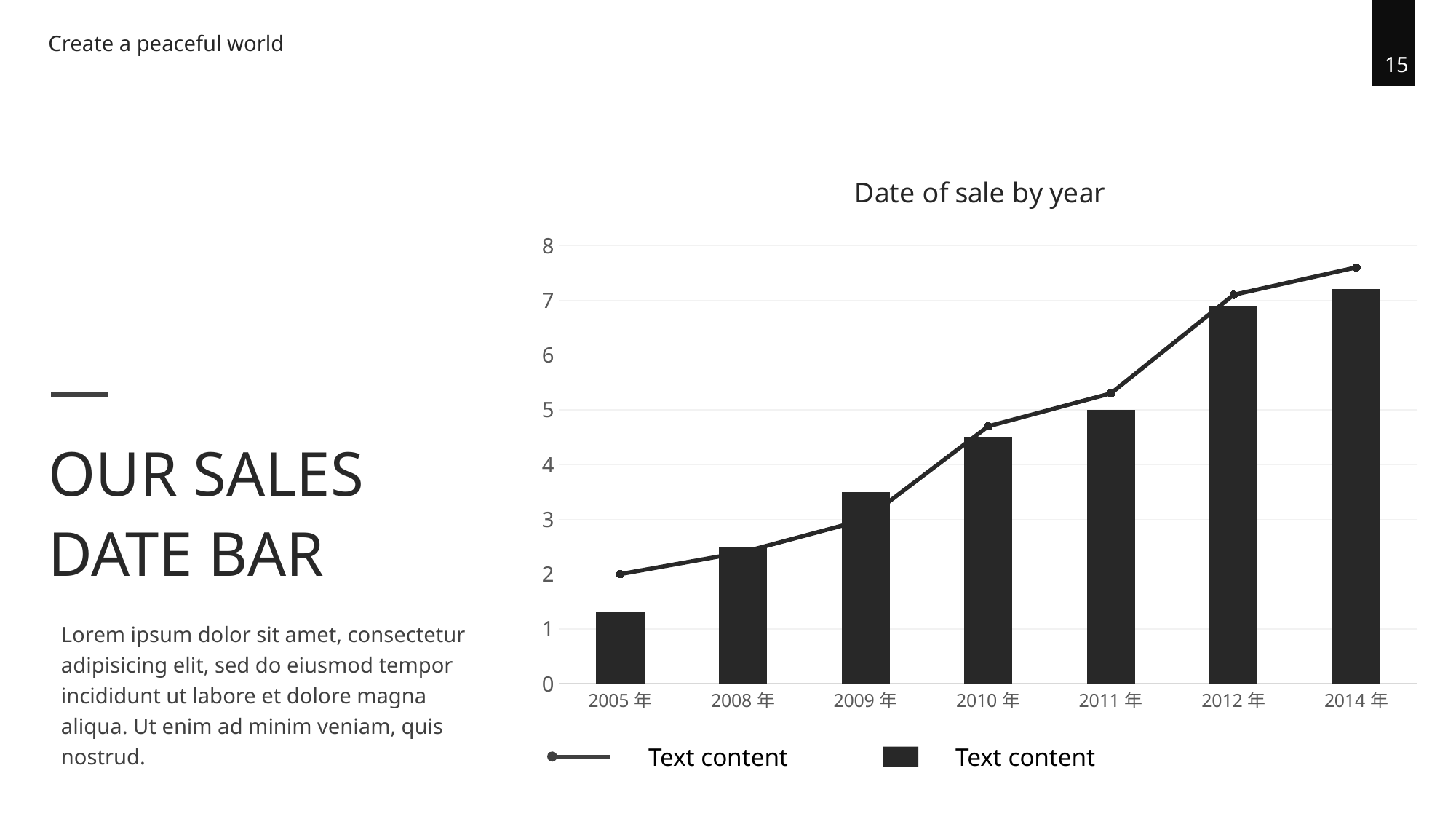
Which has the taller bar, 2008 年 or 2010 年? 2010 年 Is the line value for 2014 年 greater or less than 7? greater How many series does the chart legend list? 2 Do the bar values rise or fall from 2005 年 to 2014 年? rise Is the bar value for 2012 年 greater or less than 6? greater Which year has the shortest bar in the chart? 2005 年 Is the bar value for 2005 年 greater or less than 2? less What kind of chart is shown on the slide? Bar chart with a line series At 2014 年, which is higher, the line point or the bar? the line point How many years are shown on the x axis of the chart? 7 What is the title of the chart? Date of sale by year Which year has the tallest bar in the chart? 2014 年